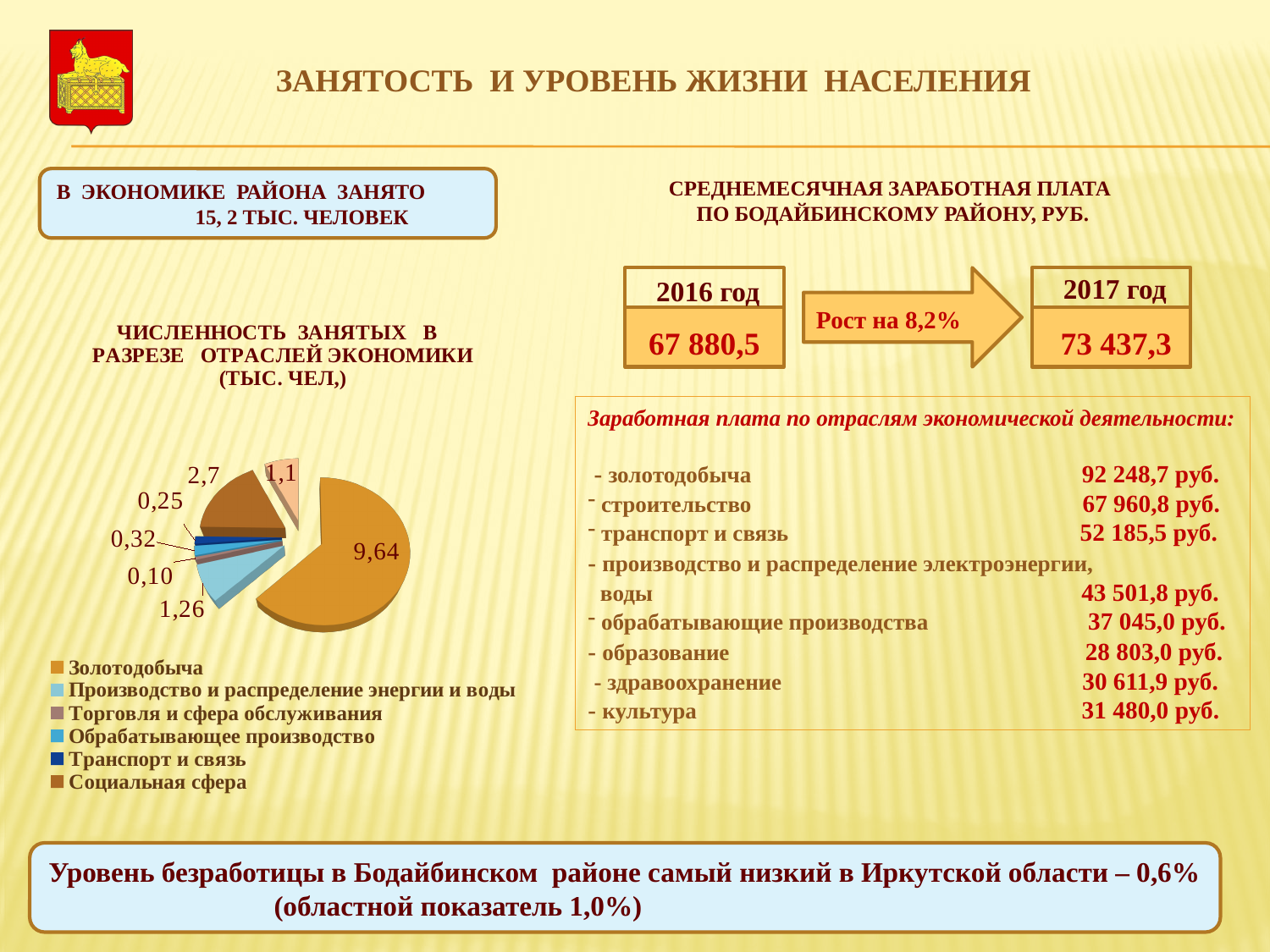
What is the value for Производство и распределение энергии и воды in the pie chart? 1,26 What is the title of the pie chart? Численность занятых в разрезе отраслей экономики (тыс. чел,) How many entries does the legend of the pie chart list? 6 What is the difference between the values for Золотодобыча and Социальная сфера in the pie chart? 6,94 Which is larger in the pie chart: Социальная сфера or Производство и распределение энергии и воды? Социальная сфера How many slices does the pie chart have? 7 What kind of chart is shown on the slide? pie chart Which legend entry is listed first under the pie chart? Золотодобыча What is the value for Золотодобыча in the pie chart? 9,64 What is the value for Социальная сфера in the pie chart? 2,7 Which category has the largest slice in the pie chart? Золотодобыча What is the smallest value labelled on the pie chart? 0,10